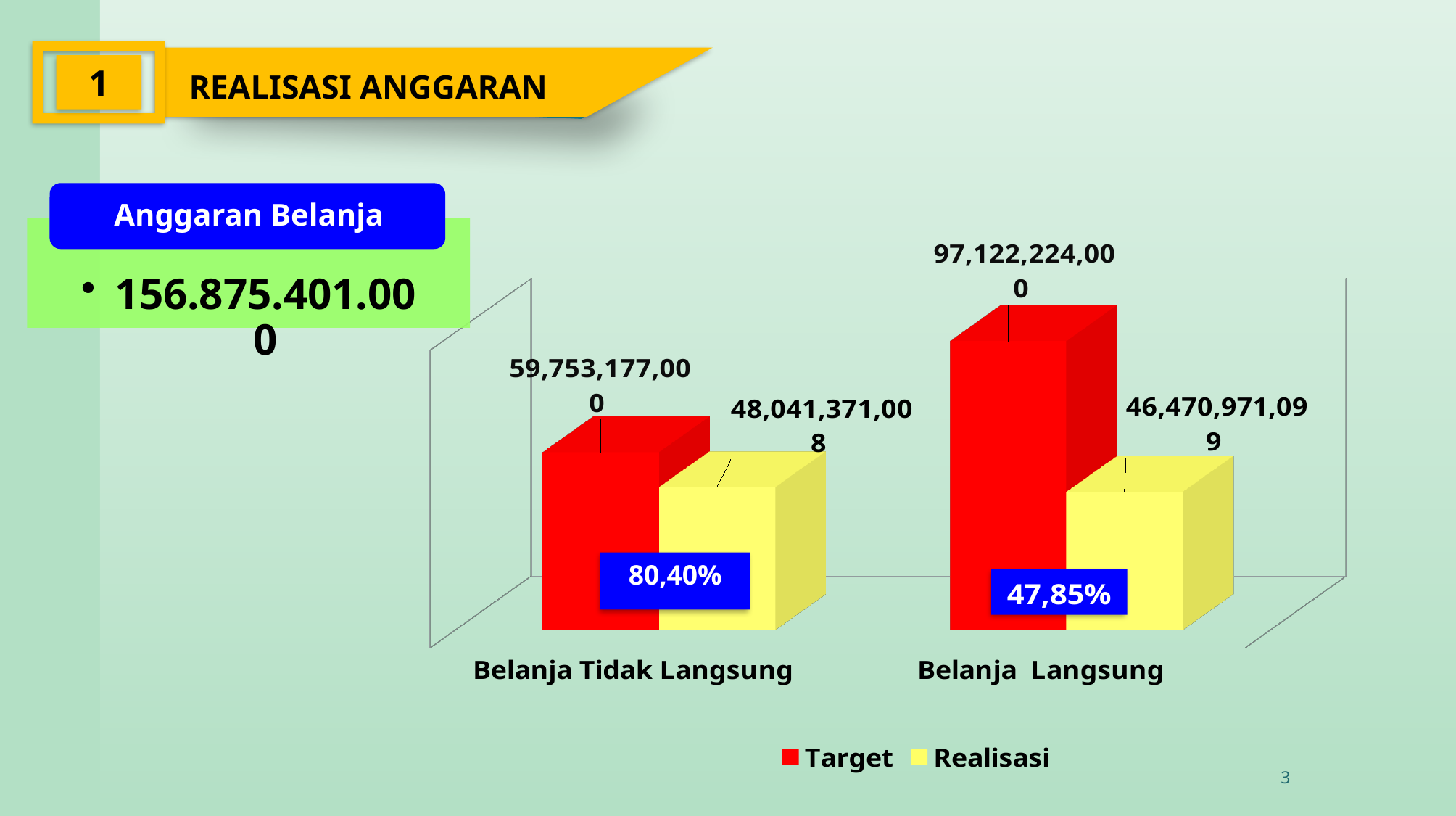
How many categories are shown on the x axis of the chart? 2 What is the Target value for Belanja Tidak Langsung? 59,753,177,000 What is the Realisasi value for Belanja Tidak Langsung? 48,041,371,008 What is the Target value for Belanja Langsung? 97,122,224,000 What is the difference between the Target values for Belanja Langsung and Belanja Tidak Langsung? 37,369,047,000 How many series does the chart legend list? 2 Which category has the lowest Realisasi value? Belanja Langsung What is the difference between the Target and Realisasi values for Belanja Langsung? 50,651,252,901 Which is larger: the Target for Belanja Tidak Langsung or the Realisasi for Belanja Tidak Langsung? Target for Belanja Tidak Langsung What is the Realisasi value for Belanja Langsung? 46,470,971,099 Which category has the highest Target value? Belanja Langsung What percentage label is shown for Belanja Langsung? 47,85%